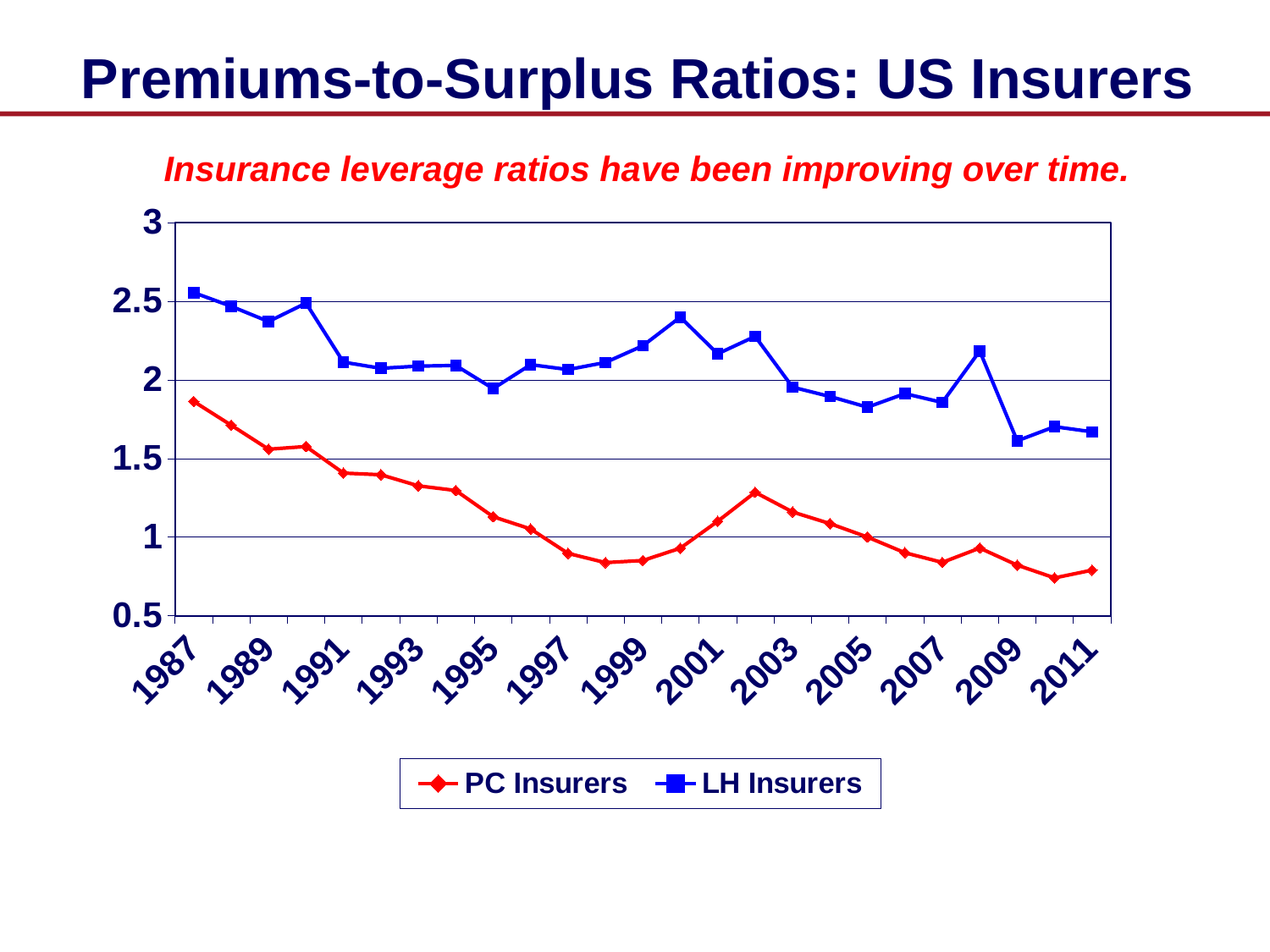
Which series has the higher value in 1987, PC Insurers or LH Insurers? LH Insurers Is the value for PC Insurers in 1987 greater or less than 1.5? greater How many series does the legend list? 2 How many yearly data points does each series have? 25 Which series is drawn in red? PC Insurers In which year is the PC Insurers ratio highest? 1987 Overall, does the PC Insurers ratio rise or fall from 1987 to 2011? fall What kind of chart is shown on the slide? line chart Is the value for LH Insurers in 2010 greater or less than 2? less Is the value for LH Insurers in 2001 greater or less than 2? greater What is the title of the slide? Premiums-to-Surplus Ratios: US Insurers